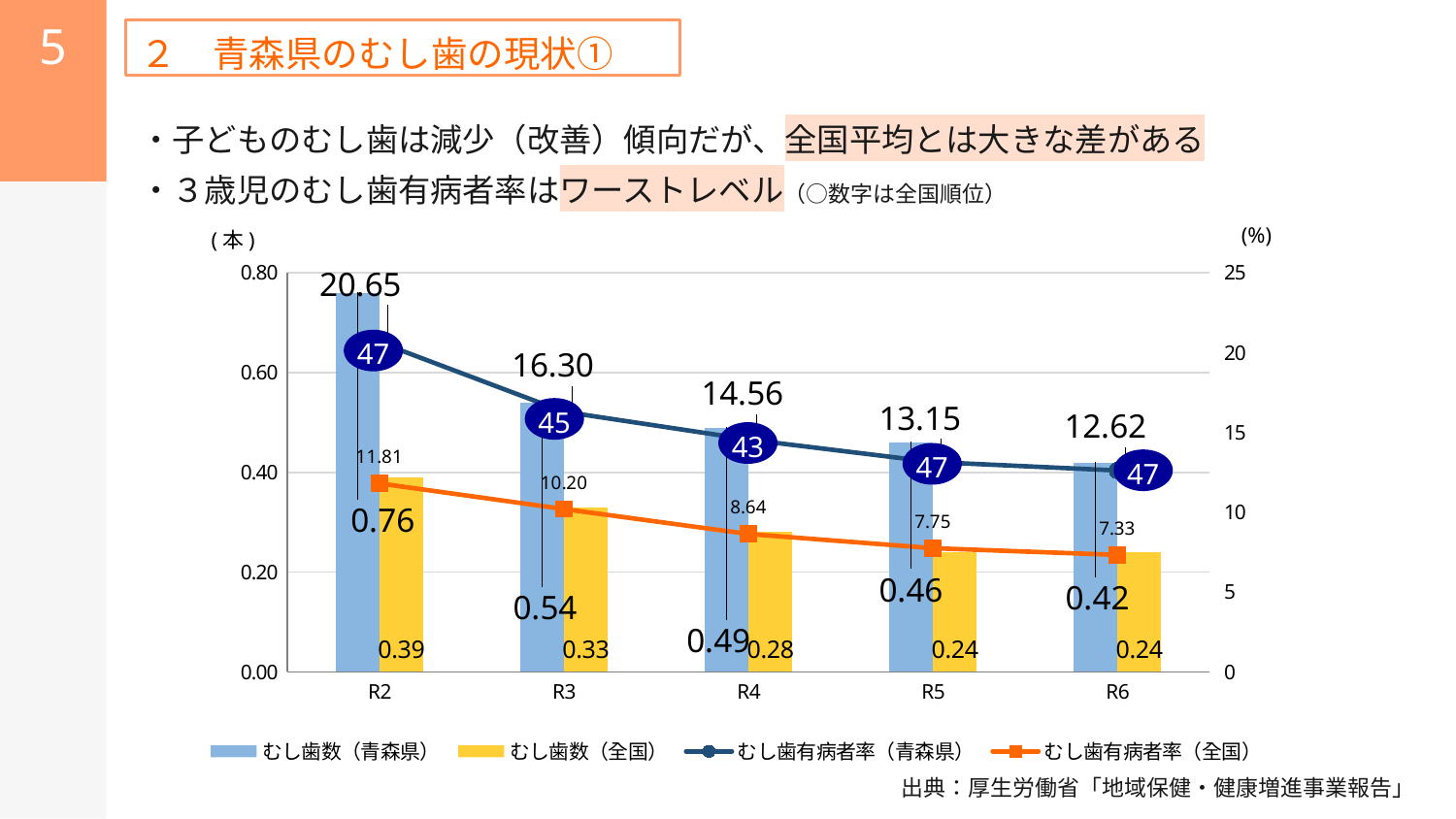
What is the value of むし歯数（全国） for R3? 0.33 What national ranking number is shown in the circle for R3? 45 Which year has the lowest value for むし歯数（青森県）? R6 How many years are shown on the x axis? 5 What is the difference between むし歯有病者率（青森県） and むし歯有病者率（全国） in R2? 8.84 How many series does the legend list? 4 What is the value of むし歯有病者率（全国） for R6? 7.33 What is the value of むし歯有病者率（青森県） for R4? 14.56 Does むし歯有病者率（青森県） rise or fall from R2 to R6? fall Which is larger in R5: むし歯数（青森県） or むし歯数（全国）? むし歯数（青森県） What is the value of むし歯数（青森県） for R2? 0.76 Which year has the highest value for むし歯有病者率（青森県）? R2